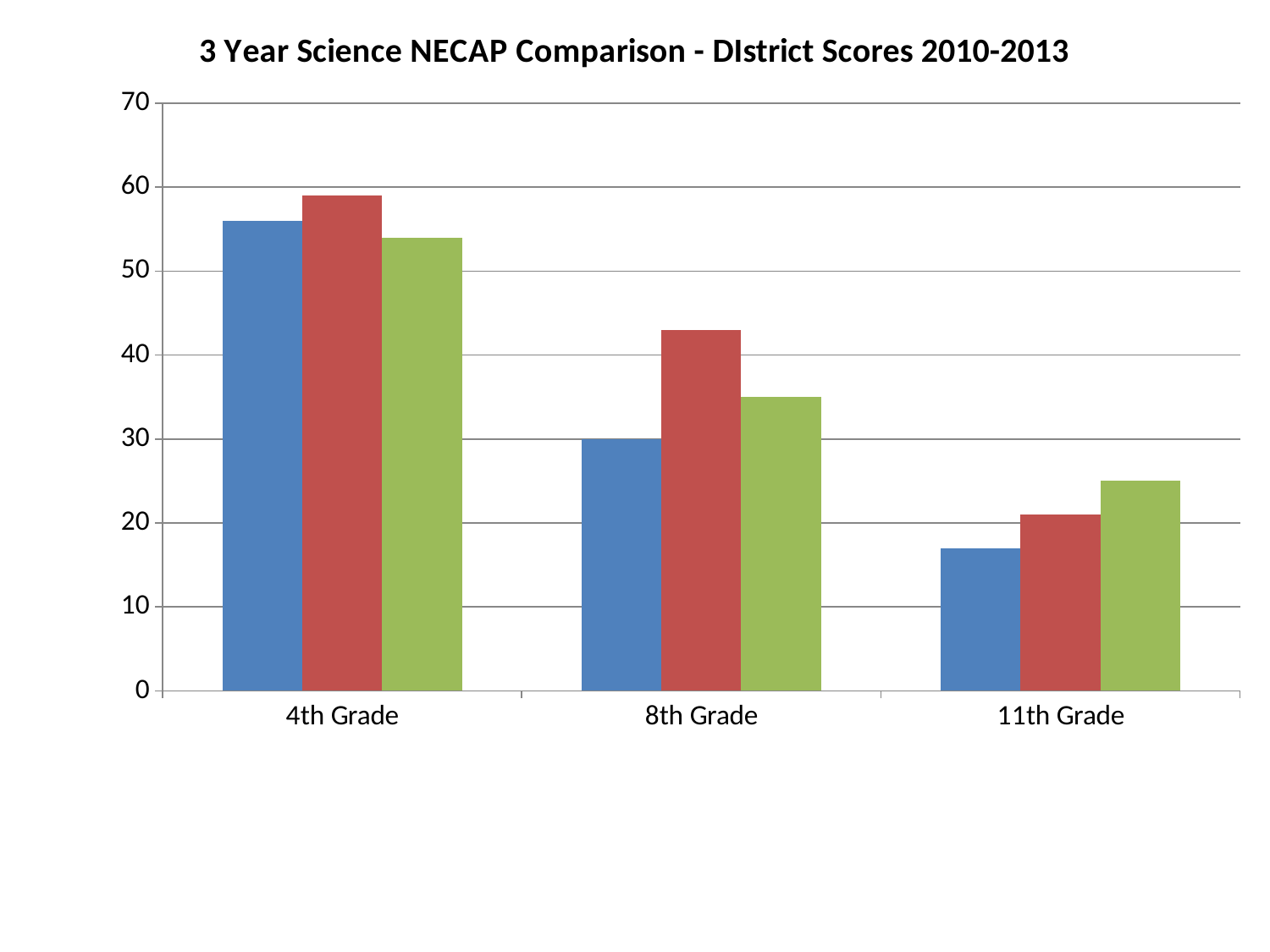
How many grade categories are shown on the x axis? 3 Is the value of the red bar for 8th Grade greater or less than 40? greater Is the value of the green bar for 11th Grade greater or less than 30? less Is the value of the red bar for 4th Grade greater or less than 50? greater For 4th Grade, which bar is taller, the red bar or the green bar? red Which grade has the lowest blue bar? 11th Grade What kind of chart is shown on the slide? bar chart What is the value of the blue bar for 8th Grade? 30 What is the title of the chart? 3 Year Science NECAP Comparison - DIstrict Scores 2010-2013 Which grade has the highest red bar? 4th Grade Do the blue bars rise or fall from 4th Grade to 11th Grade? fall How many bars are plotted for each grade category? 3